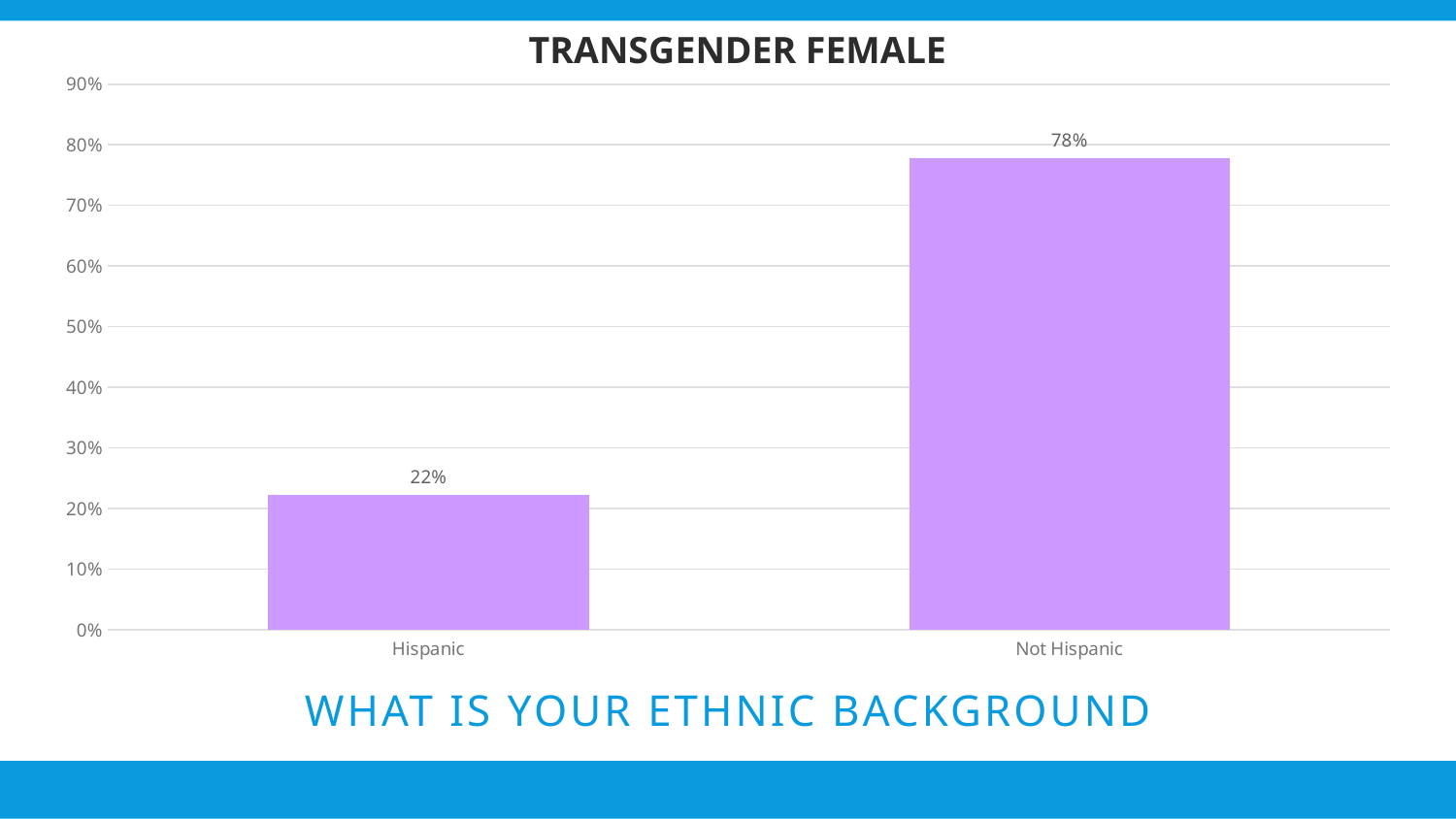
What is the highest value shown on the y axis? 90% What is the title of the chart? TRANSGENDER FEMALE Which category has the highest value? Not Hispanic How many categories are shown on the x axis? 2 What kind of chart is shown on the slide? bar chart Which category has the lowest value? Hispanic What is the value for Not Hispanic? 78% What is the value for Hispanic? 22% Is the value for Hispanic greater or less than 30%? less Is the value for Not Hispanic greater or less than 70%? greater What is the difference between the values for Not Hispanic and Hispanic? 56% Which is larger, the value for Hispanic or the value for Not Hispanic? Not Hispanic